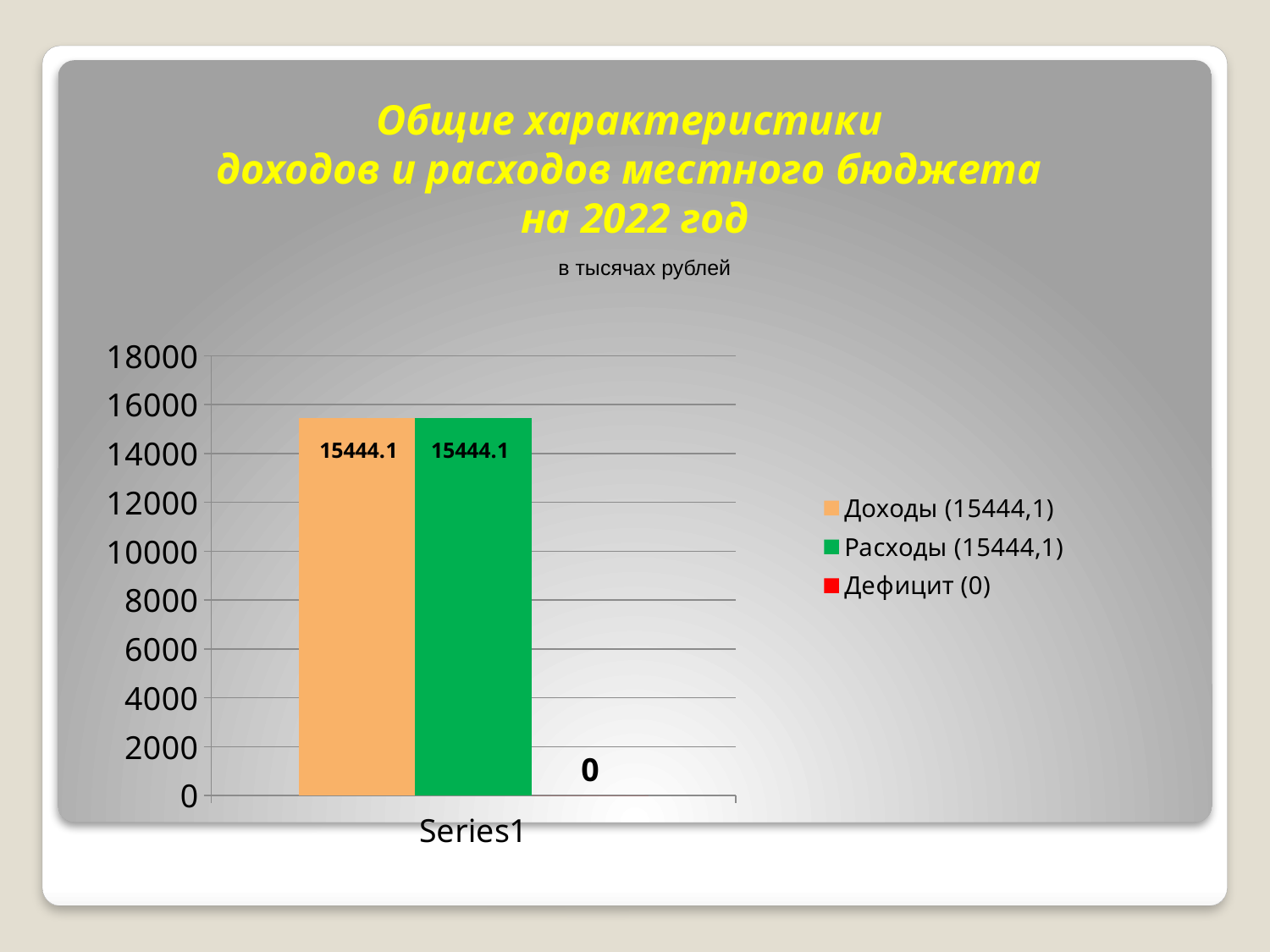
What is the value shown for Дефицит? 0 What is the value of the Расходы bar? 15444.1 Is the value for Доходы greater or less than 14000? greater Which series has the lowest value? Дефицит What is the difference between the Доходы and Расходы values? 0 What is the category label shown on the x axis? Series1 How many series does the legend list? 3 Is the value for Расходы greater or less than 16000? less What colour is the Расходы bar? green What is the highest value shown on the y axis? 18000 What kind of chart is shown on the slide? bar chart What is the value of the Доходы bar? 15444.1